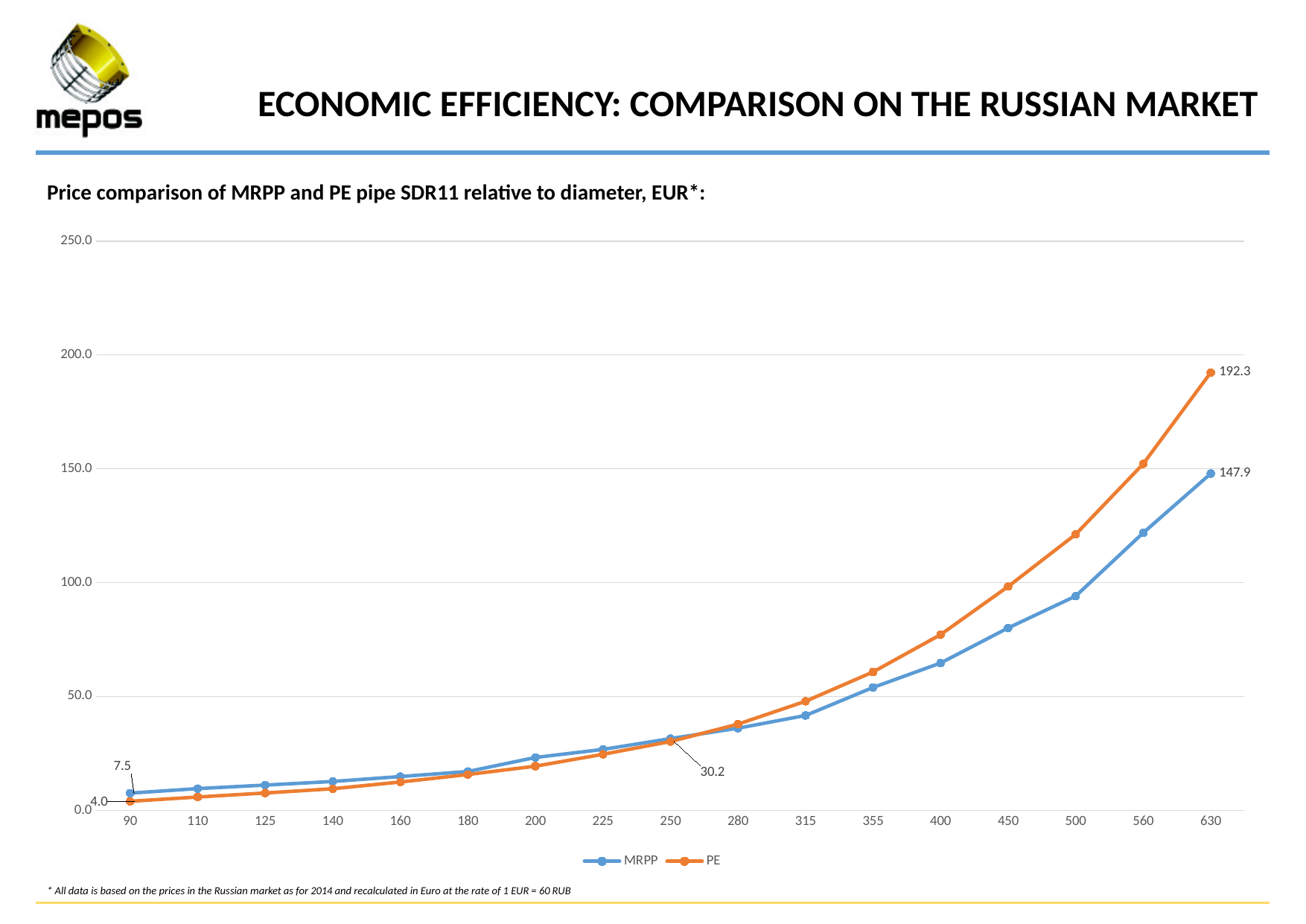
At diameter 90, which series has the higher value, MRPP or PE? MRPP What is the MRPP value at diameter 90? 7.5 What is the difference between the MRPP and PE values at diameter 90? 3.6 How many series does the legend list? 2 What is the difference between the PE and MRPP values at diameter 630? 44.4 What is the MRPP value at diameter 630? 147.9 Is the MRPP value at diameter 400 greater or less than 100? less How many diameter values are plotted on the x axis? 17 Is the PE value at diameter 500 greater or less than 100? greater What is the PE value at diameter 630? 192.3 What is the PE value at diameter 90? 4.0 At diameter 630, which series has the higher value, MRPP or PE? PE